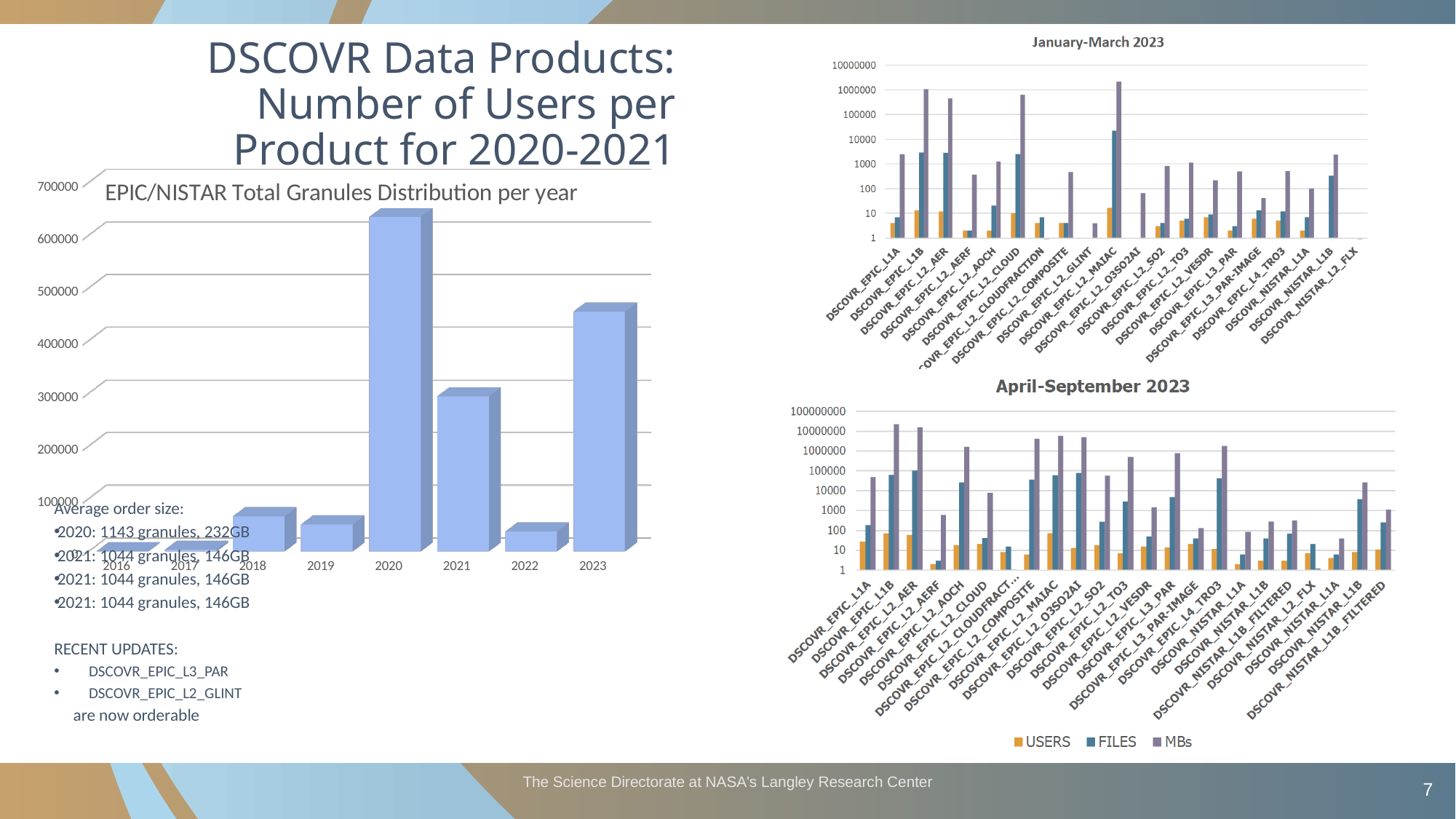
What kind of chart is the 'EPIC/NISTAR Total Granules Distribution per year' chart on the left? bar chart In the 'January-March 2023' chart, which product has the highest MBs value? DSCOVR_EPIC_L2_MAIAC In the 'EPIC/NISTAR Total Granules Distribution per year' chart, is the value for 2022 greater or less than 100000? less In the 'EPIC/NISTAR Total Granules Distribution per year' chart, is the value for 2023 greater or less than 400000? greater In the 'April-September 2023' chart, which product has the highest MBs value? DSCOVR_EPIC_L1B In the 'EPIC/NISTAR Total Granules Distribution per year' chart, do the values rise or fall from 2020 to 2022? fall In the 'EPIC/NISTAR Total Granules Distribution per year' chart, is the value for 2020 greater or less than 600000? greater How many series does the legend below the 'April-September 2023' chart list? 3 In the 'EPIC/NISTAR Total Granules Distribution per year' chart, which year has the highest value? 2020 What are the series names in the legend below the 'April-September 2023' chart? USERS, FILES, MBs In the 'EPIC/NISTAR Total Granules Distribution per year' chart, which is larger, the value for 2021 or the value for 2023? 2023 In the 'EPIC/NISTAR Total Granules Distribution per year' chart, how many years are shown on the x axis? 8